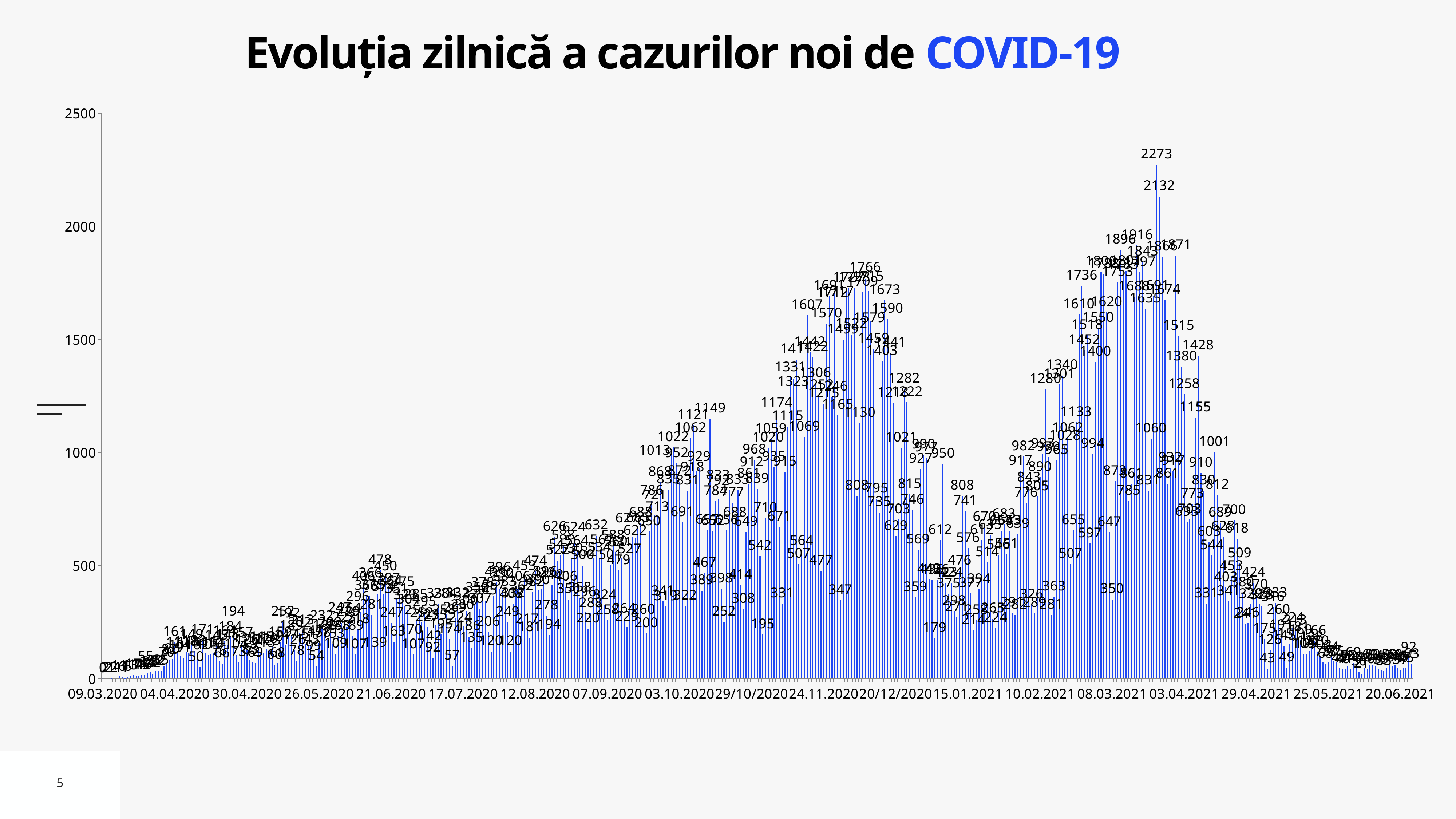
Are the values at the far left start of the chart (around 09.03.2020) greater or less than 500? less Is the highest value on the chart greater or less than 2000? greater What kind of chart is shown on the slide? bar chart What is the difference between the two highest labeled values, 2273 and 2132? 141 What is the highest daily value labeled on the chart? 2273 Are the values at the far right end of the chart (around 20.06.2021) greater or less than 500? less What is the second-highest daily value labeled on the chart, next to the 2273 peak? 2132 What is the first date label on the x axis? 09.03.2020 What is the last date label on the x axis? 20.06.2021 What is the title of the chart? Evoluția zilnică a cazurilor noi de COVID-19 Which wave reached the higher peak: the one around November 2020 or the one around April 2021? April 2021 What colour are the bars in the chart? blue